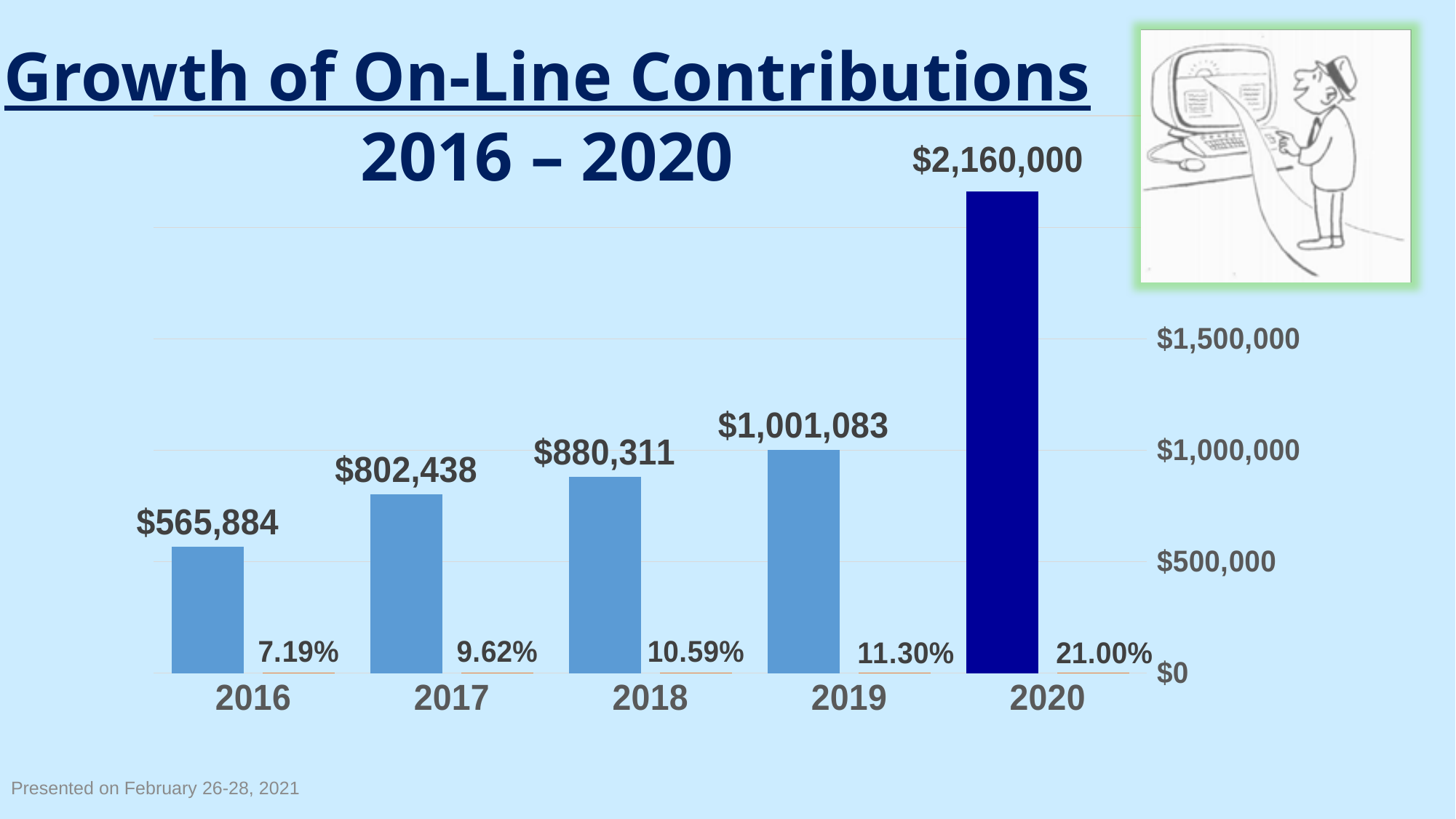
What is the value of on-line contributions for 2018? $880,311 What is the difference between the 2017 and 2016 contribution values? $236,554 Which year has the lowest on-line contributions? 2016 Which year has the highest on-line contributions? 2020 Do the contribution values rise or fall from 2016 to 2020? Rise What kind of chart is shown on the slide? Bar chart What percentage is shown next to the 2019 bar? 11.30% Which year has larger contributions, 2017 or 2018? 2018 What is the value of on-line contributions for 2020? $2,160,000 What is the difference between the 2020 and 2019 contribution values? $1,158,917 How many years are shown on the x axis of the chart? 5 What is the value of on-line contributions for 2016? $565,884